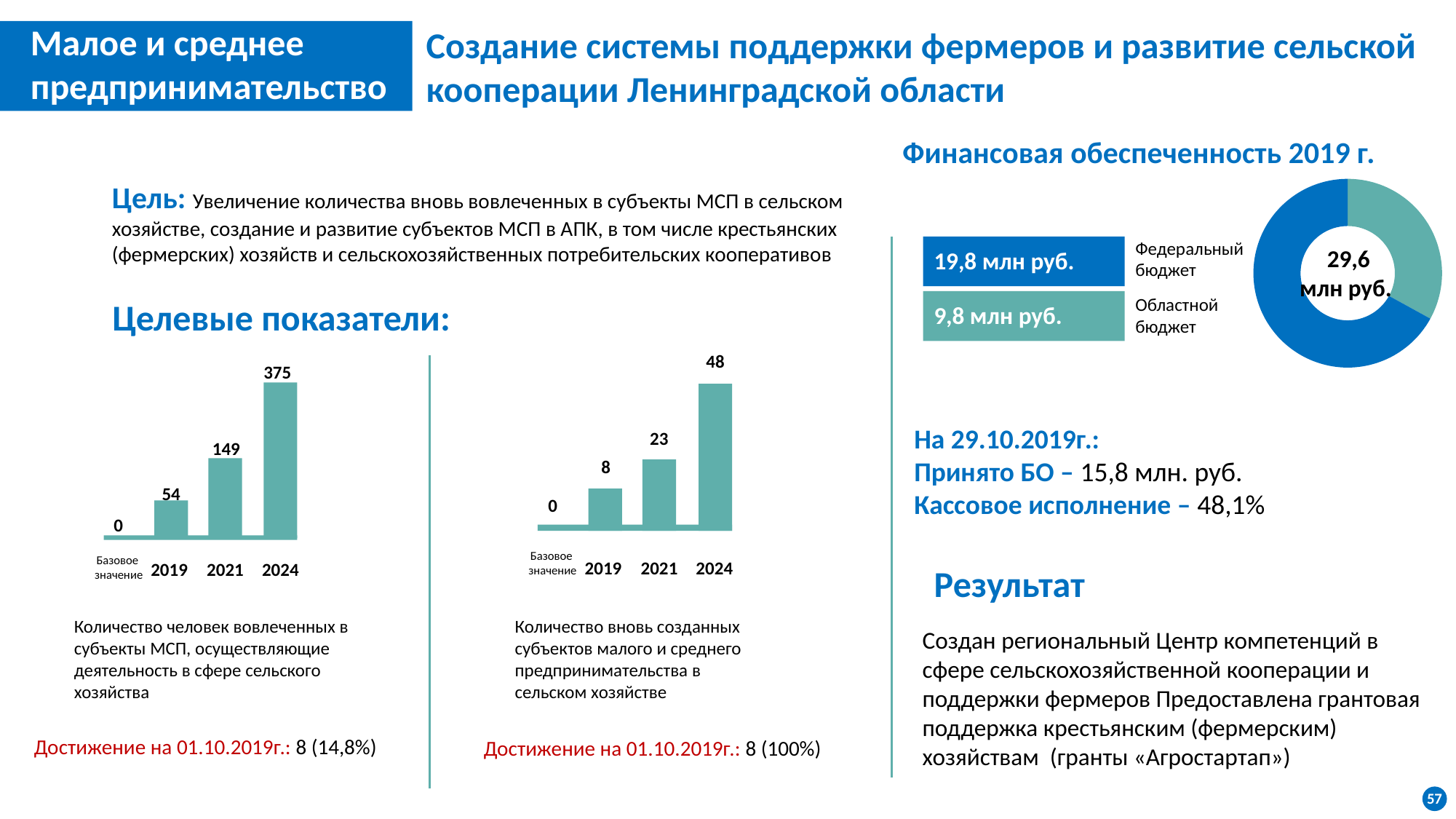
On the left bar chart (Количество человек вовлеченных в субъекты МСП), what is the value for 2019? 54 On the left bar chart (Количество человек вовлеченных в субъекты МСП), what is the difference between the 2024 and 2021 values? 226 On the middle bar chart (Количество вновь созданных субъектов МСП), how many categories are shown on the x axis? 4 What kind of chart is used for Финансовая обеспеченность 2019 г.? doughnut chart On the middle bar chart (Количество вновь созданных субъектов МСП), what is the value for 2021? 23 On the Финансовая обеспеченность 2019 г. chart, which is larger: Федеральный бюджет or Областной бюджет? Федеральный бюджет On the middle bar chart (Количество вновь созданных субъектов МСП), what is the difference between the 2024 and 2019 values? 40 On the middle bar chart (Количество вновь созданных субъектов МСП), which category has the highest value? 2024 On the left bar chart (Количество человек вовлеченных в субъекты МСП), do the values rise or fall from left to right? rise On the left bar chart (Количество человек вовлеченных в субъекты МСП), what is the value for 2024? 375 On the Финансовая обеспеченность 2019 г. chart, what is the value for Федеральный бюджет? 19,8 млн руб. On the left bar chart (Количество человек вовлеченных в субъекты МСП), which category has the lowest value? Базовое значение